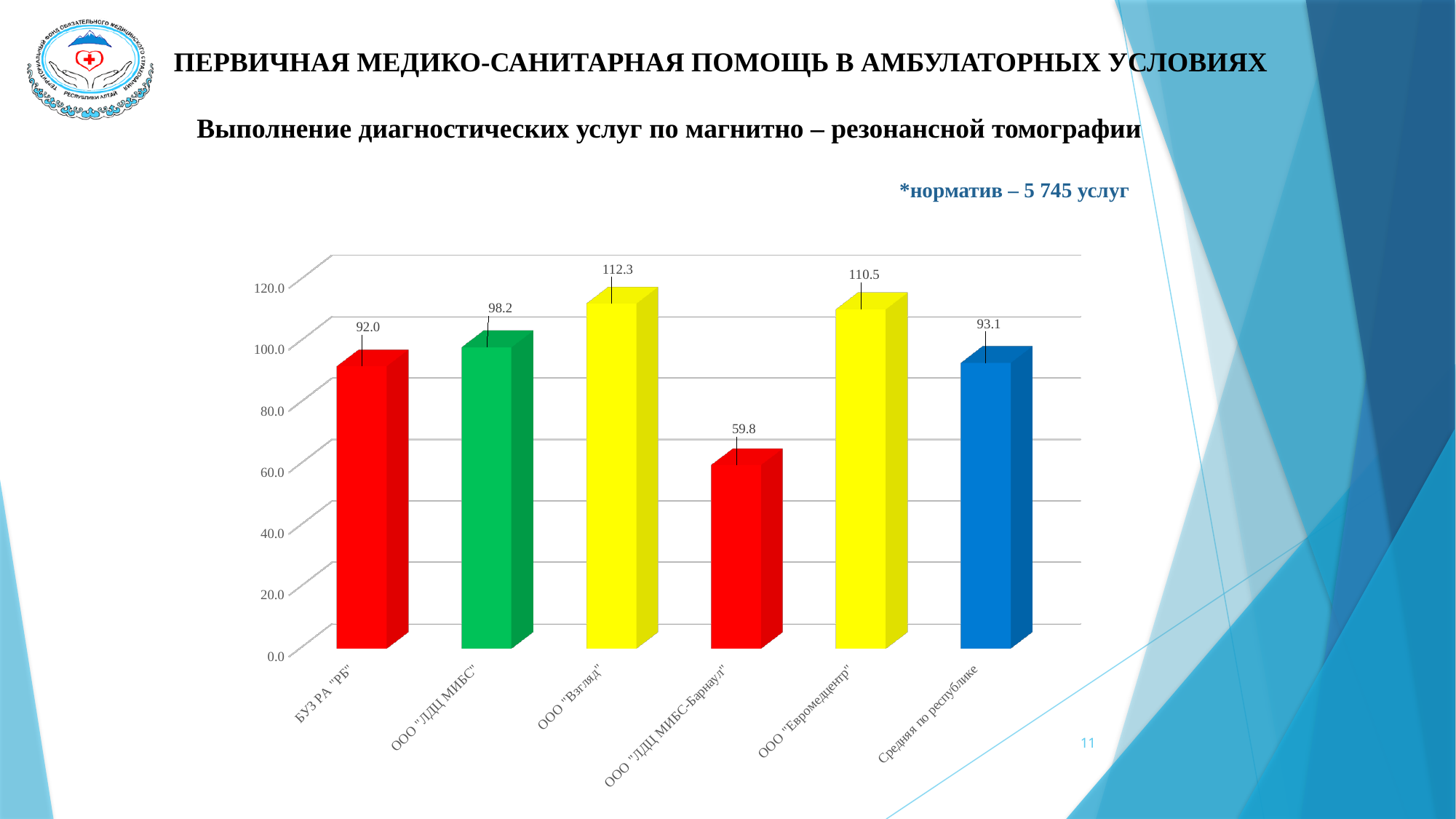
What kind of chart is shown on the slide? bar chart Is the value for ООО "Евромедцентр" greater or less than 100.0? greater What is the value for ООО "Взгляд"? 112.3 What is the value for Средняя по республике? 93.1 How many categories are shown on the chart? 6 Which category has the lowest value? ООО "ЛДЦ МИБС-Барнаул" What is the value for БУЗ РА "РБ"? 92.0 What is the difference between the values for ООО "Взгляд" and ООО "Евромедцентр"? 1.8 Which is larger, the value for ООО "ЛДЦ МИБС" or the value for Средняя по республике? ООО "ЛДЦ МИБС" What is the norm (норматив) stated above the chart? 5 745 услуг What is the value for ООО "ЛДЦ МИБС-Барнаул"? 59.8 Which category has the highest value? ООО "Взгляд"